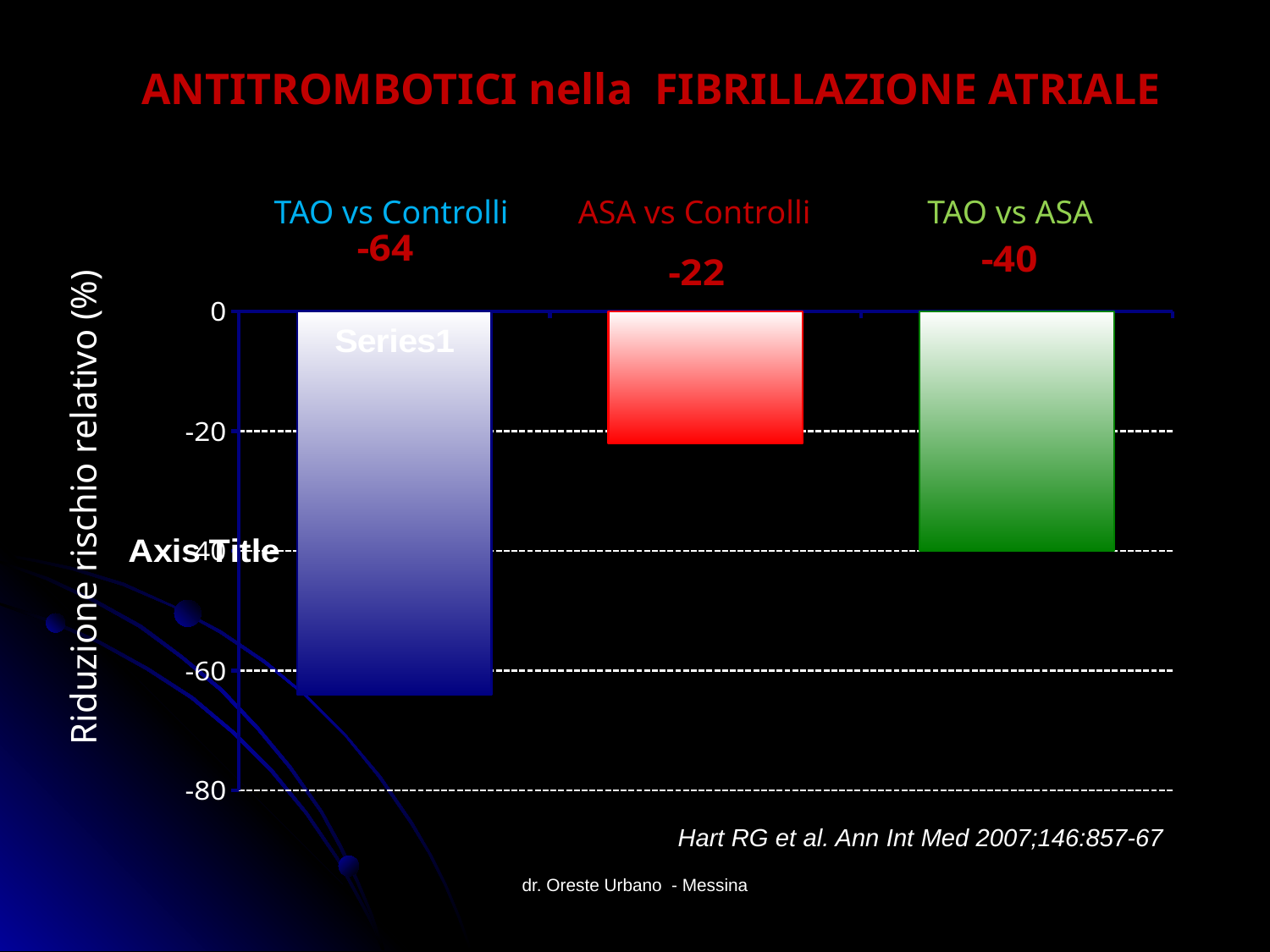
What is the difference between the values for TAO vs Controlli and ASA vs Controlli? 42 What is the difference between the values for TAO vs ASA and ASA vs Controlli? 18 Which comparison shows the smallest relative risk reduction (the value closest to 0)? ASA vs Controlli What is the label of the vertical axis? Riduzione rischio relativo (%) What type of chart is shown on the slide? bar chart How many bars are plotted in the chart? 3 What is the value shown for TAO vs ASA? -40 What is the value shown for TAO vs Controlli? -64 Is the value for TAO vs Controlli greater or less than -60? less Which comparison shows the largest relative risk reduction (the most negative value)? TAO vs Controlli What is the value shown for ASA vs Controlli? -22 Which bar extends further below zero, TAO vs ASA or ASA vs Controlli? TAO vs ASA